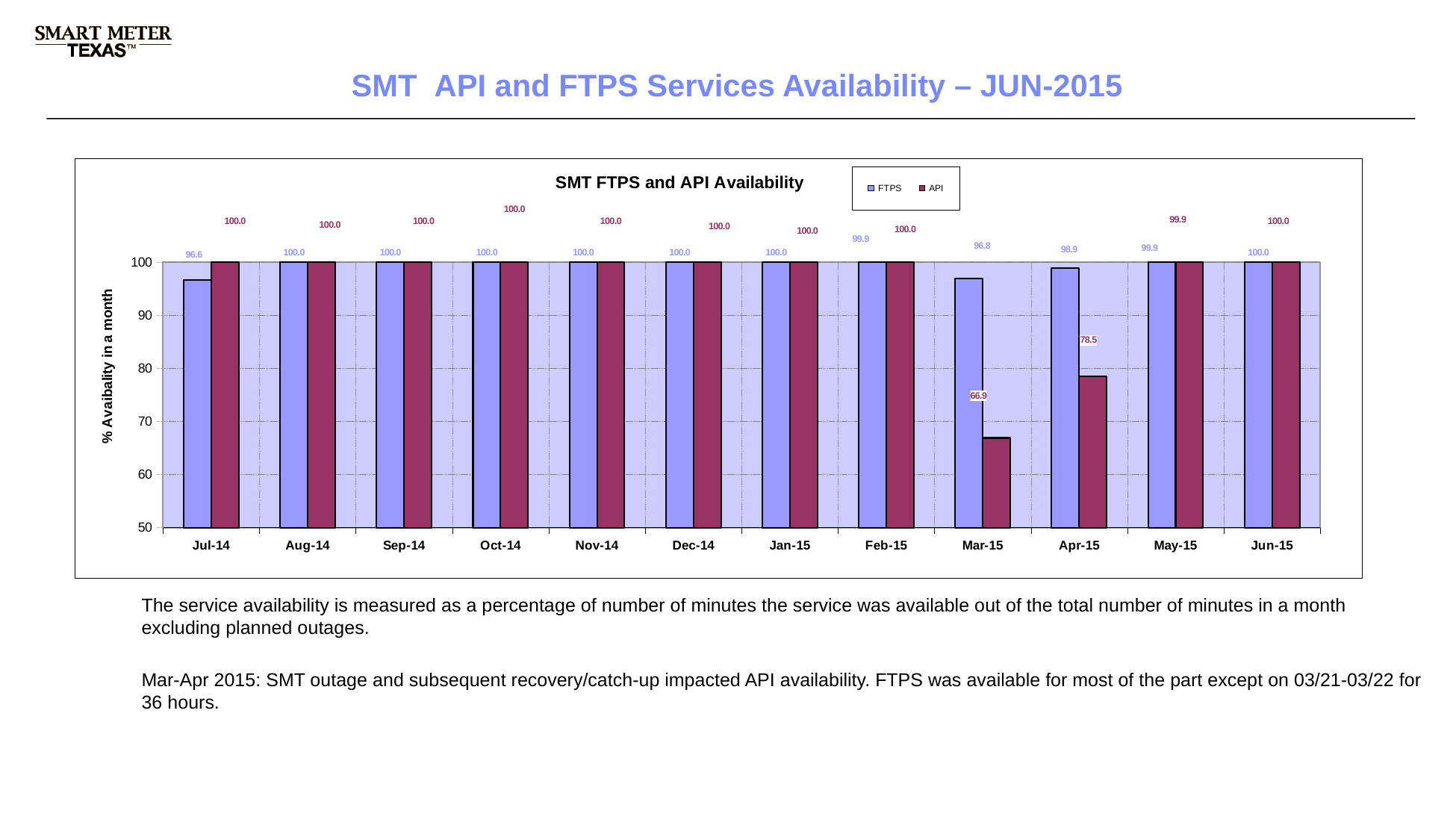
How many months are shown on the x axis? 12 How many series does the legend list? 2 What is the FTPS availability value for Apr-15? 98.9 What is the FTPS availability value for Jul-14? 96.6 Which is larger in Apr-15, the FTPS value or the API value? FTPS What type of chart is shown? Bar chart What is the API availability value for Apr-15? 78.5 What is the API availability value for Mar-15? 66.9 Which month has the lowest FTPS availability? Jul-14 What is the difference between the FTPS and API values for Mar-15? 29.9 Which month has the lowest API availability? Mar-15 Is the API value for Apr-15 greater or less than 80? less